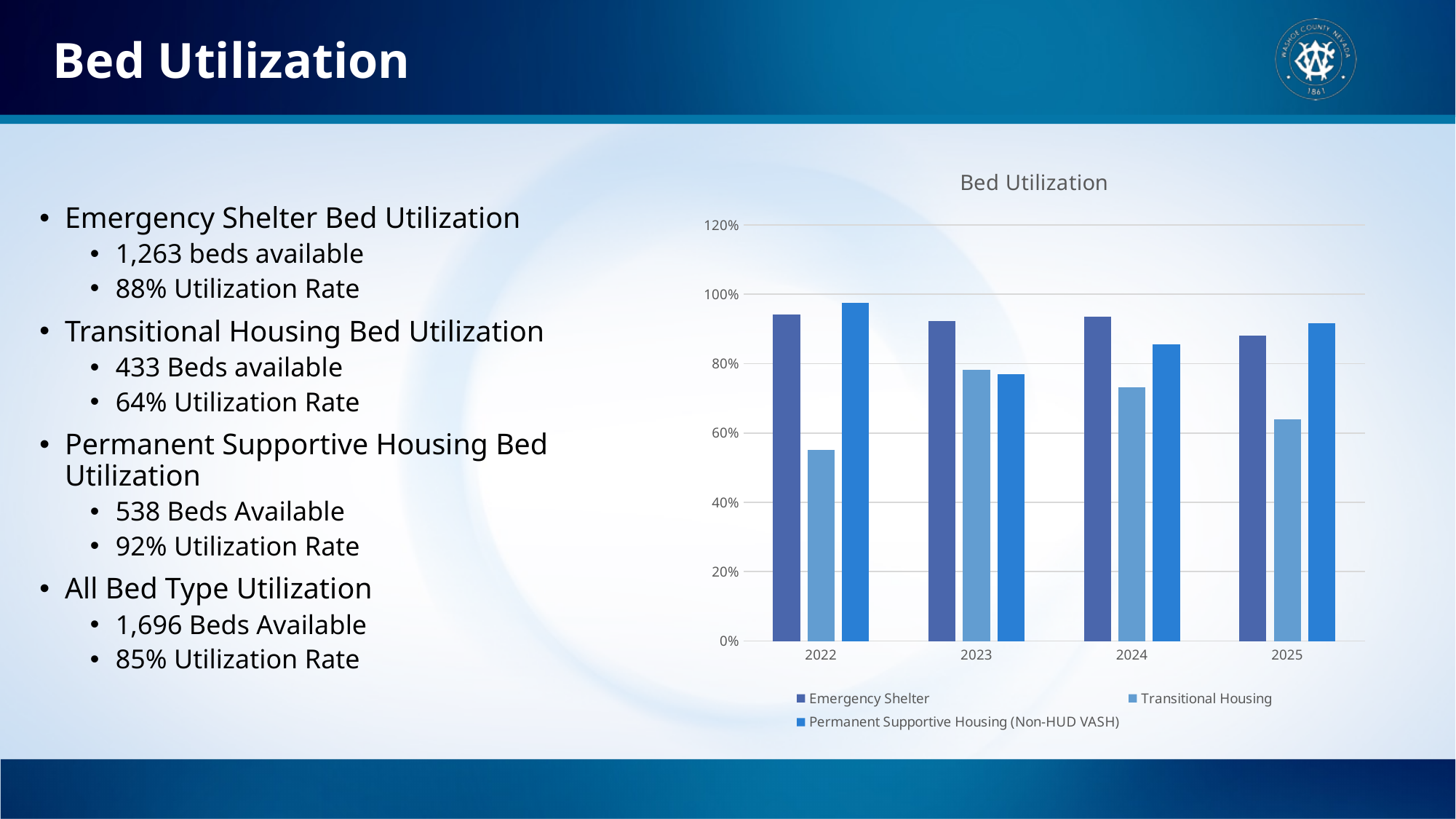
In which year is the Transitional Housing bar lowest? 2022 Does the Emergency Shelter value rise or fall from 2024 to 2025? fall How many series does the chart legend list? 3 How many years are shown on the x axis of the chart? 4 In 2024, which is larger: Emergency Shelter or Permanent Supportive Housing (Non-HUD VASH)? Emergency Shelter In which year is the Permanent Supportive Housing (Non-HUD VASH) bar highest? 2022 What kind of chart is shown on the slide? Bar chart In 2022, which is larger: Transitional Housing or Permanent Supportive Housing (Non-HUD VASH)? Permanent Supportive Housing (Non-HUD VASH) Is the Transitional Housing value for 2024 greater or less than 80%? less Is the Transitional Housing value for 2022 greater or less than 60%? less Is the Emergency Shelter value for 2025 greater or less than 80%? greater